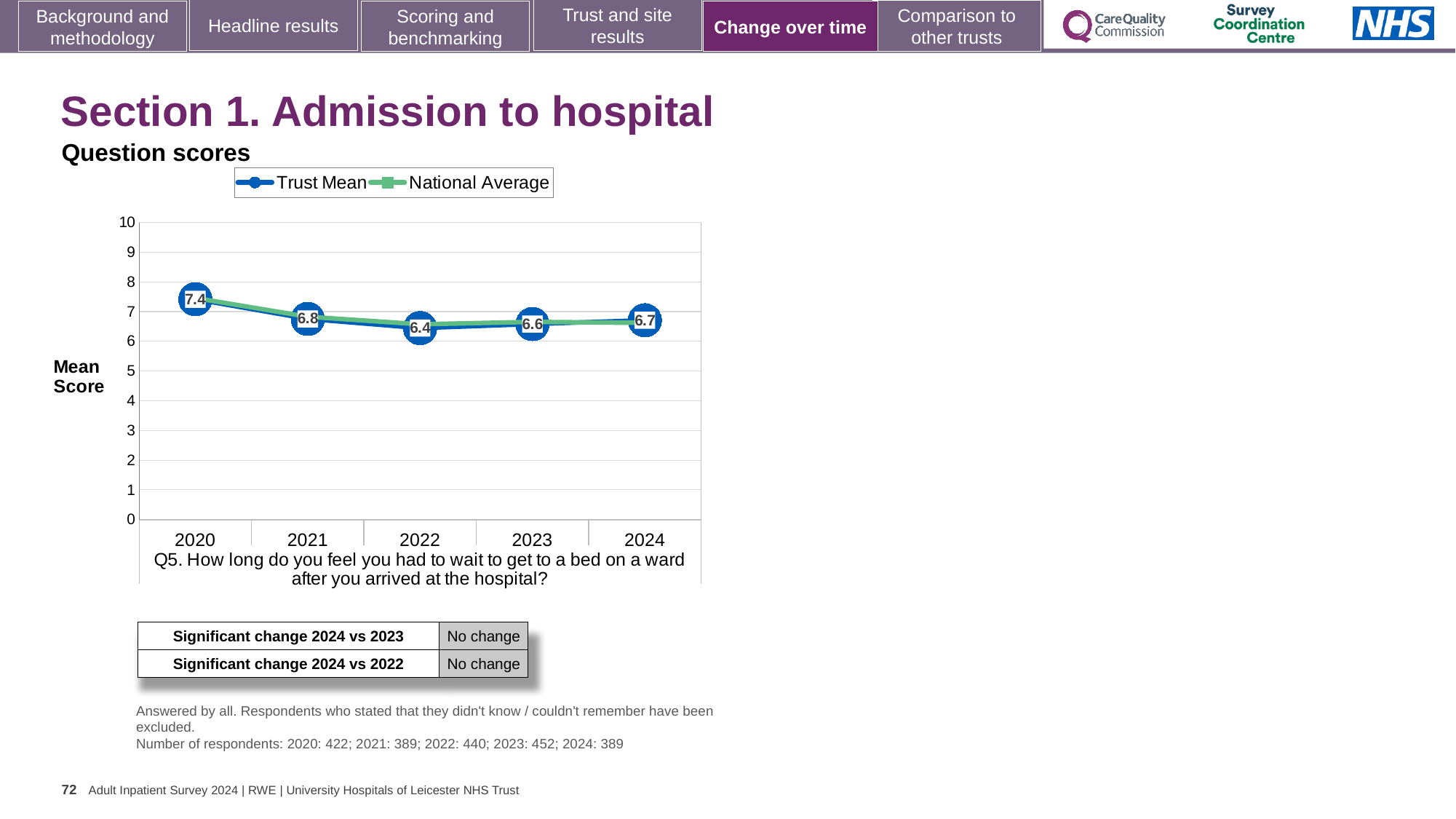
What is the difference between the Trust Mean score in 2020 and in 2022? 1.0 Which year has a higher Trust Mean score, 2021 or 2023? 2021 In which year is the Trust Mean score lowest? 2022 What is the Trust Mean score for 2024? 6.7 How many series does the legend list? 2 How many years are plotted on the x axis? 5 In which year is the Trust Mean score highest? 2020 Is the Trust Mean score for 2023 greater or less than 7? less What is the Trust Mean score for 2021? 6.8 What is the Trust Mean score for 2020? 7.4 What is the Trust Mean score for 2022? 6.4 What kind of chart is shown on the slide? Line chart